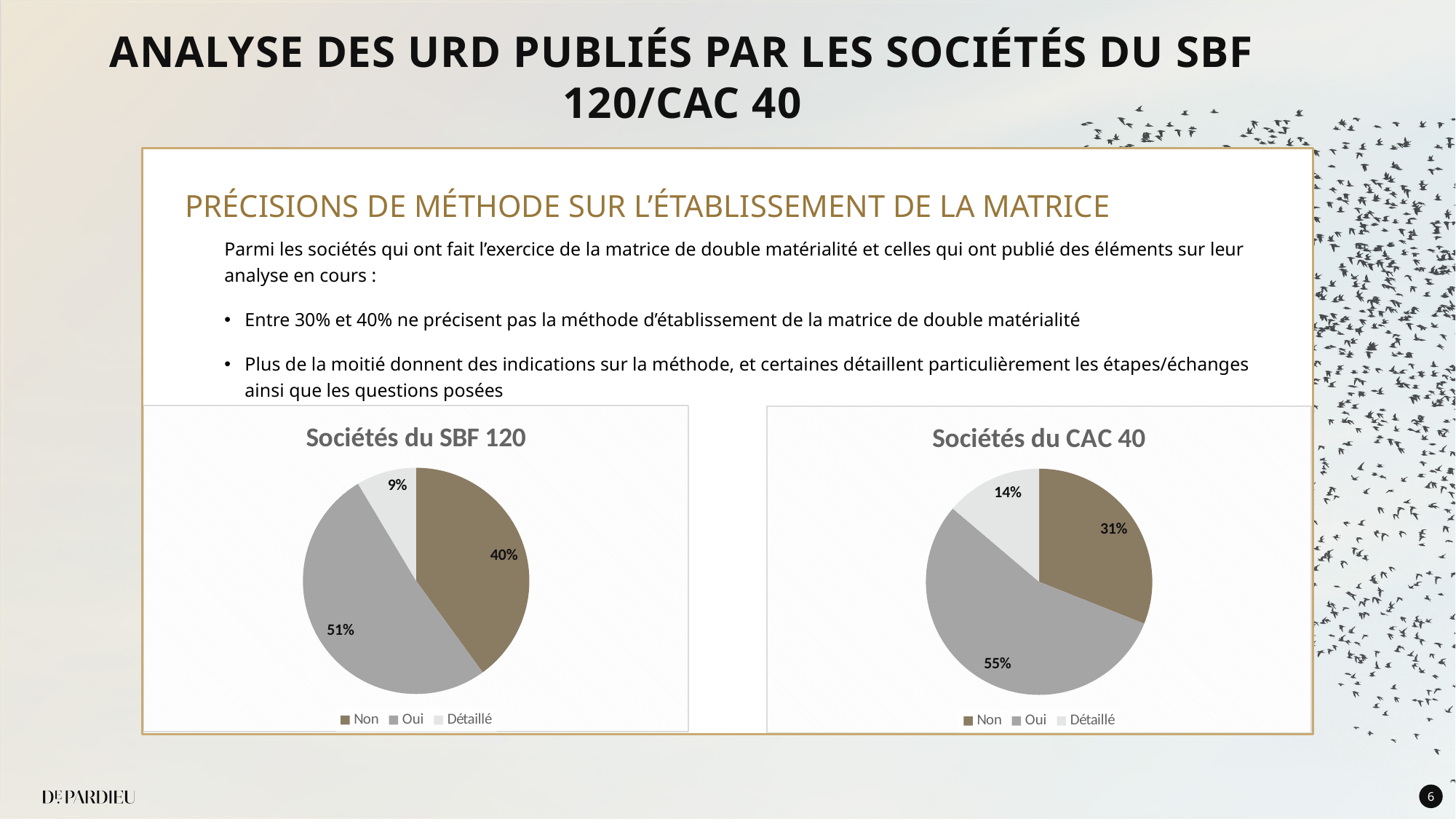
In the 'Sociétés du SBF 120' chart, what share is labelled for 'Détaillé'? 9% In the 'Sociétés du SBF 120' chart, what share is labelled for 'Oui'? 51% In the 'Sociétés du CAC 40' chart, what share is labelled for 'Détaillé'? 14% In the 'Sociétés du CAC 40' chart, what share is labelled for 'Non'? 31% In the 'Sociétés du SBF 120' chart, which category has the largest slice? Oui In the 'Sociétés du CAC 40' chart, what share is labelled for 'Oui'? 55% How many categories does the legend of the 'Sociétés du SBF 120' chart list? 3 What kind of chart is the 'Sociétés du CAC 40' chart? Pie chart In the 'Sociétés du SBF 120' chart, what share is labelled for 'Non'? 40% In the 'Sociétés du CAC 40' chart, what is the difference between the 'Oui' and 'Non' shares? 24% Which is larger: the 'Non' share in the 'Sociétés du SBF 120' chart or the 'Non' share in the 'Sociétés du CAC 40' chart? Sociétés du SBF 120 In the 'Sociétés du CAC 40' chart, which category has the smallest slice? Détaillé